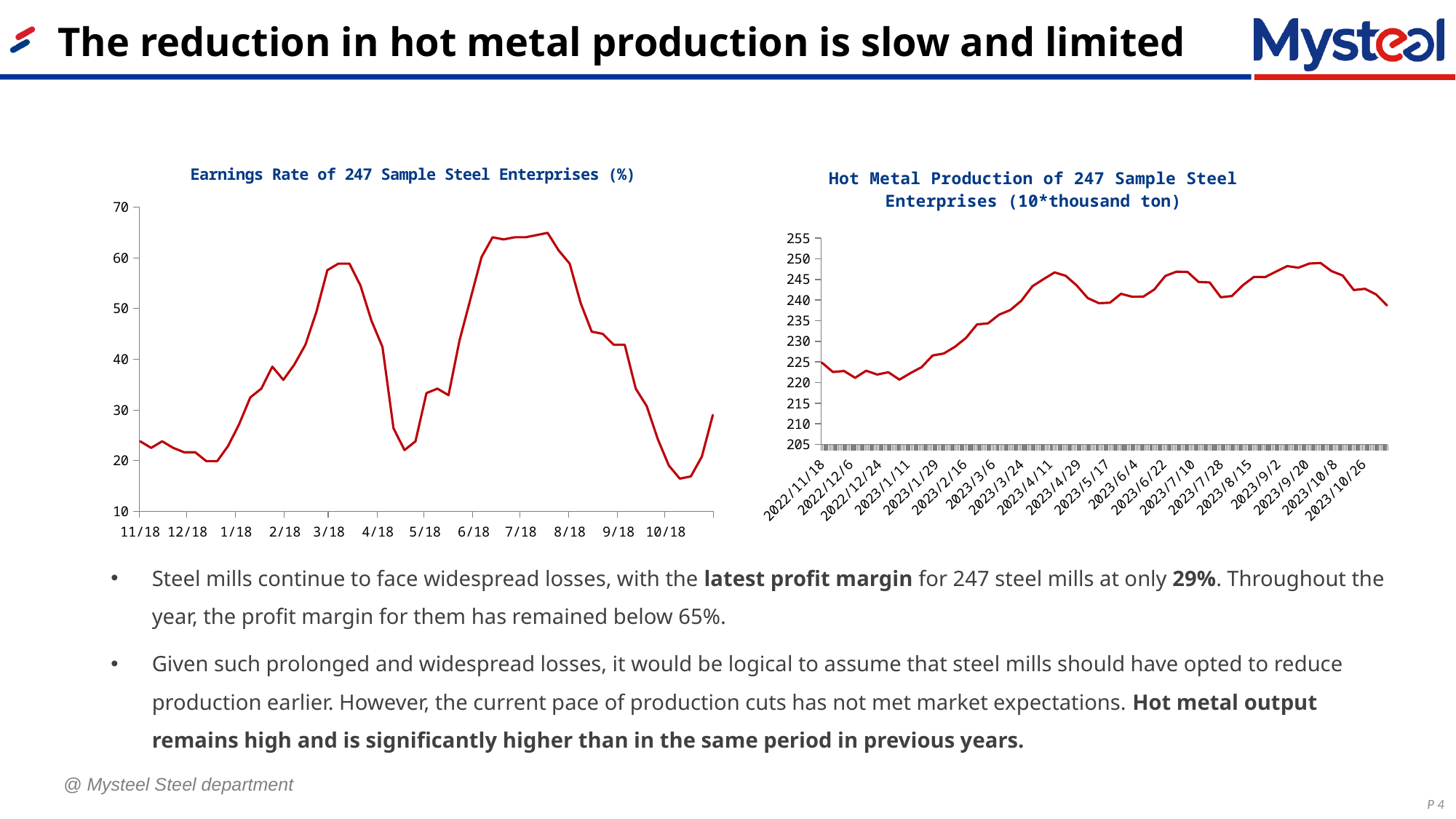
What kind of chart is the 'Hot Metal Production of 247 Sample Steel Enterprises' chart? line chart In the 'Hot Metal Production of 247 Sample Steel Enterprises' chart, is the value at 2022/11/18 greater or less than 230? less In the 'Hot Metal Production of 247 Sample Steel Enterprises' chart, does the line generally rise or fall from 2022/11/18 to 2023/4/11? rise What kind of chart is the 'Earnings Rate of 247 Sample Steel Enterprises (%)' chart? line chart In the 'Hot Metal Production of 247 Sample Steel Enterprises' chart, is the value at 2023/9/20 greater or less than 245? greater What is the title of the left-hand chart on the slide? Earnings Rate of 247 Sample Steel Enterprises (%) In the 'Earnings Rate of 247 Sample Steel Enterprises (%)' chart, does the line generally rise or fall from 7/18 to 10/18? fall In the 'Earnings Rate of 247 Sample Steel Enterprises (%)' chart, is the value at 7/18 greater or less than 60? greater What unit is given in the title of the right-hand chart on hot metal production? 10*thousand ton